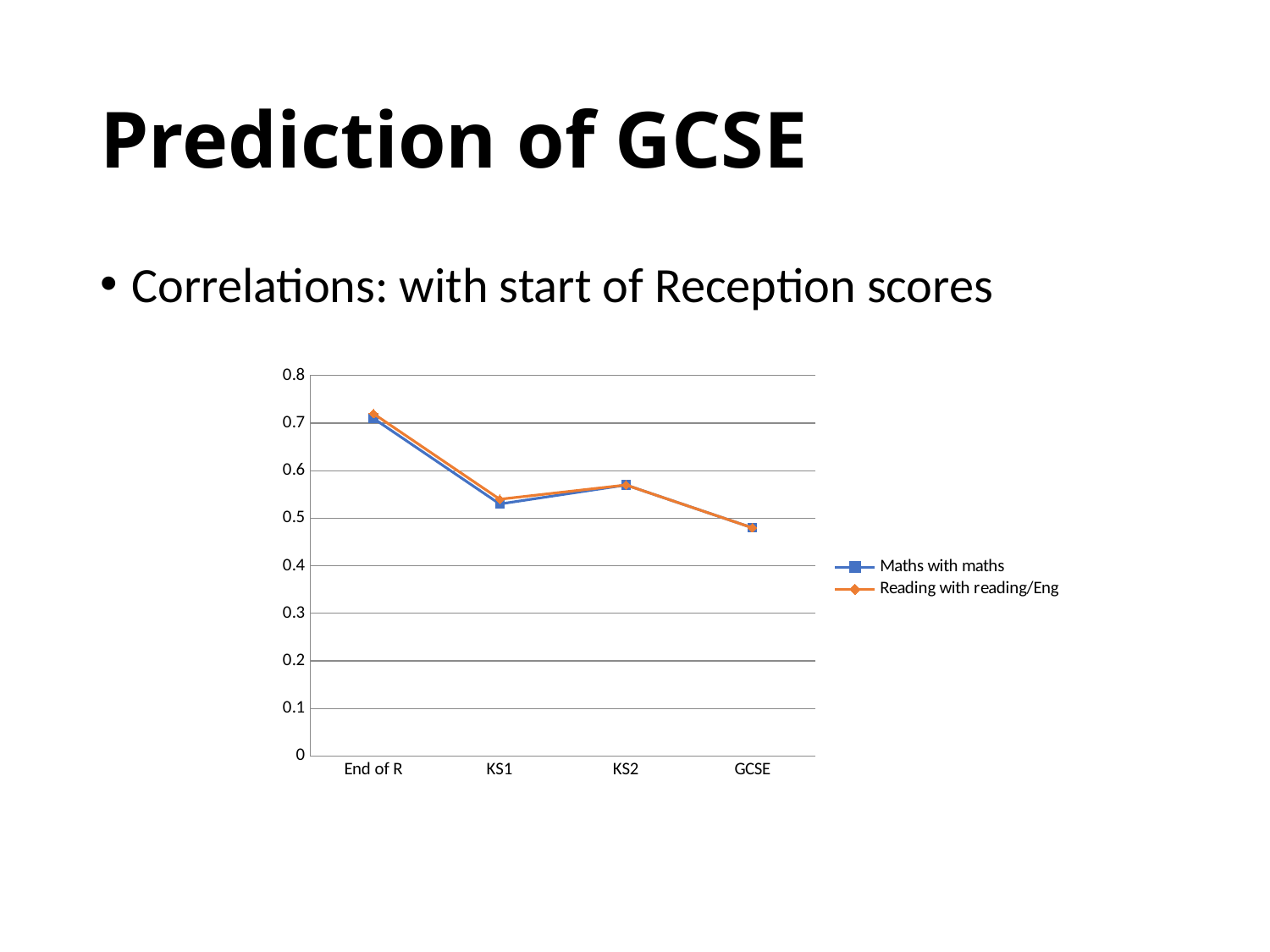
Is the value for KS2 in the Reading with reading/Eng series greater or less than 0.5? greater Is the value for KS1 in the Maths with maths series greater or less than 0.6? less Is the value for GCSE in the Reading with reading/Eng series greater or less than 0.5? less How many series does the legend list? 2 How many categories are shown on the x axis? 4 Do the values for the Maths with maths series generally rise or fall from End of R to GCSE? fall Which category has the highest value for the Maths with maths series? End of R For the Maths with maths series, which is larger: the value at End of R or the value at GCSE? End of R Which category has the lowest value for the Reading with reading/Eng series? GCSE What kind of chart is shown on the slide? line chart What are the two series names listed in the legend? Maths with maths; Reading with reading/Eng